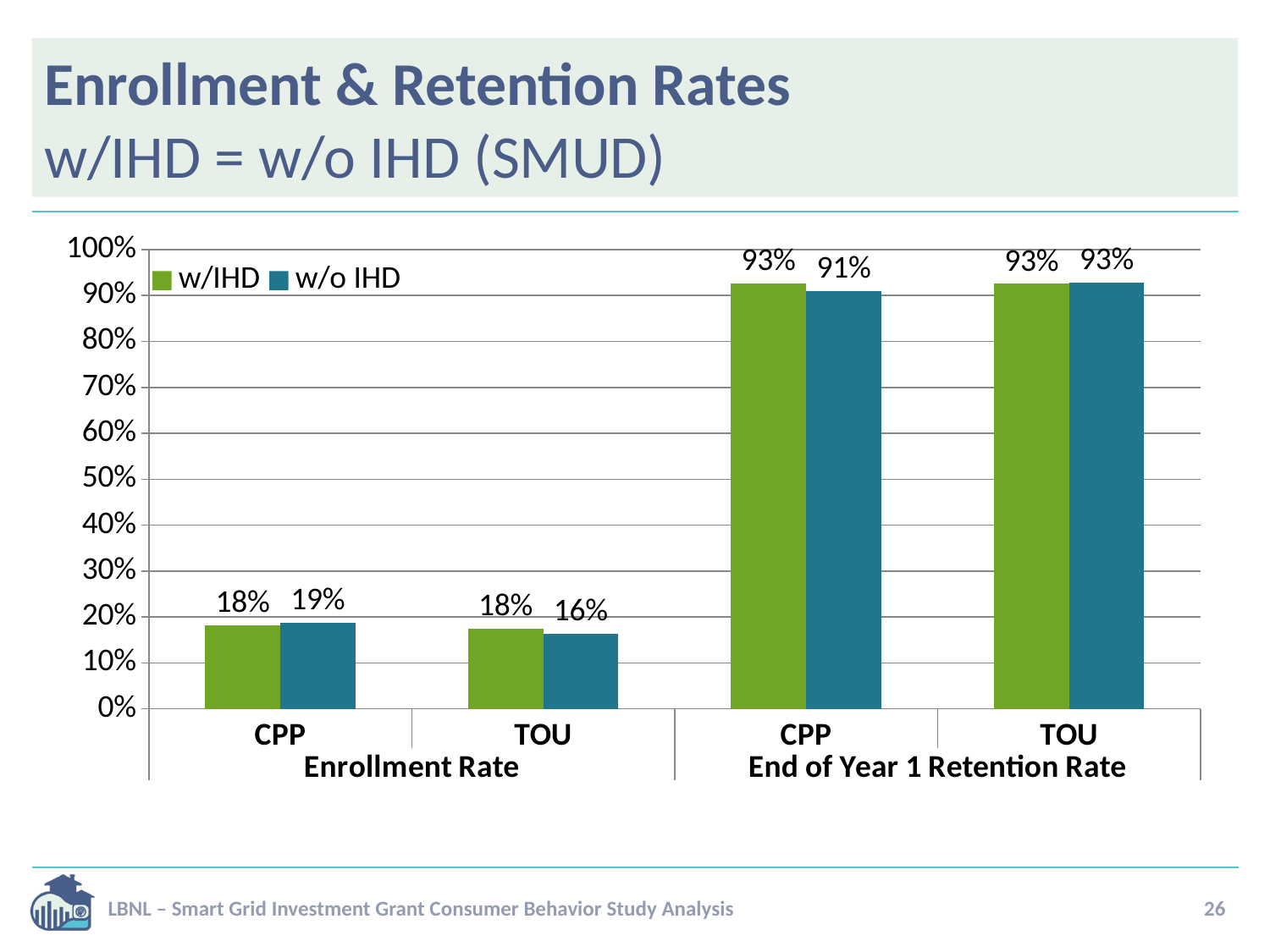
What is the w/o IHD End of Year 1 Retention Rate for CPP? 91% What is the w/IHD enrollment rate for CPP? 18% How many category groups are shown along the x axis? 4 How many series does the legend list? 2 Which is larger for TOU enrollment rate: w/IHD or w/o IHD? w/IHD What is the w/o IHD enrollment rate for TOU? 16% What is the difference between the w/IHD and w/o IHD enrollment rates for TOU? 2% Which colour represents the w/o IHD series? Teal (blue-green) What is the difference between the w/IHD and w/o IHD End of Year 1 Retention Rates for CPP? 2% Which is larger for CPP enrollment rate: w/IHD or w/o IHD? w/o IHD What kind of chart is shown on the slide? Bar chart What is the w/IHD End of Year 1 Retention Rate for TOU? 93%